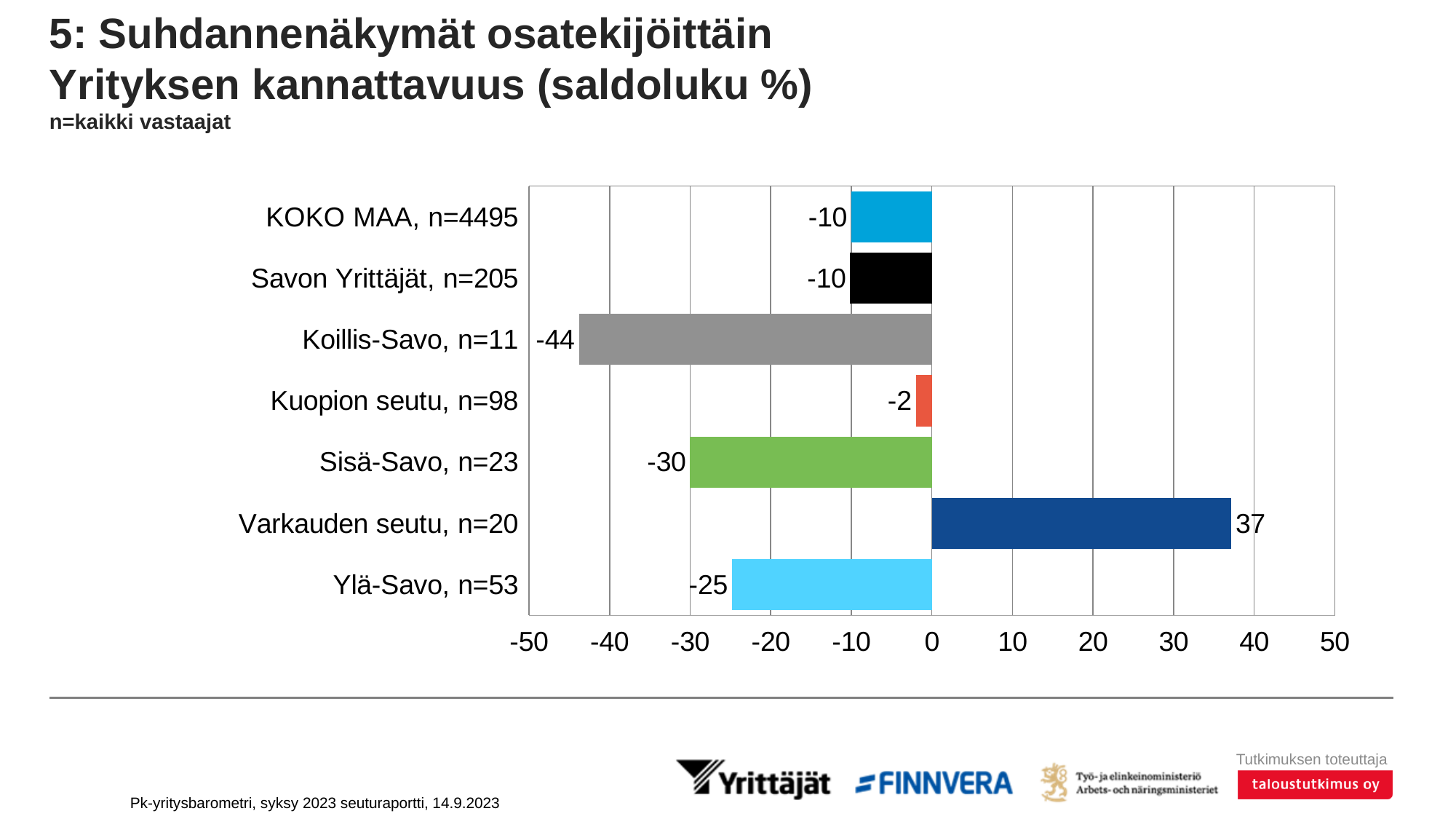
Which category has the lowest value? Koillis-Savo, n=11 What is the difference between the values for Varkauden seutu, n=20 and Koillis-Savo, n=11? 81 What is the value for Koillis-Savo, n=11? -44 What is the value for Varkauden seutu, n=20? 37 What kind of chart is shown on the slide? Bar chart Which category has the highest value? Varkauden seutu, n=20 Which is larger, the value for Sisä-Savo, n=23 or the value for Ylä-Savo, n=53? Ylä-Savo, n=53 How many categories are shown in the chart? 7 What is the difference between the values for Sisä-Savo, n=23 and Ylä-Savo, n=53? 5 What is the value for Ylä-Savo, n=53? -25 What is the value for Kuopion seutu, n=98? -2 What is the value for Savon Yrittäjät, n=205? -10